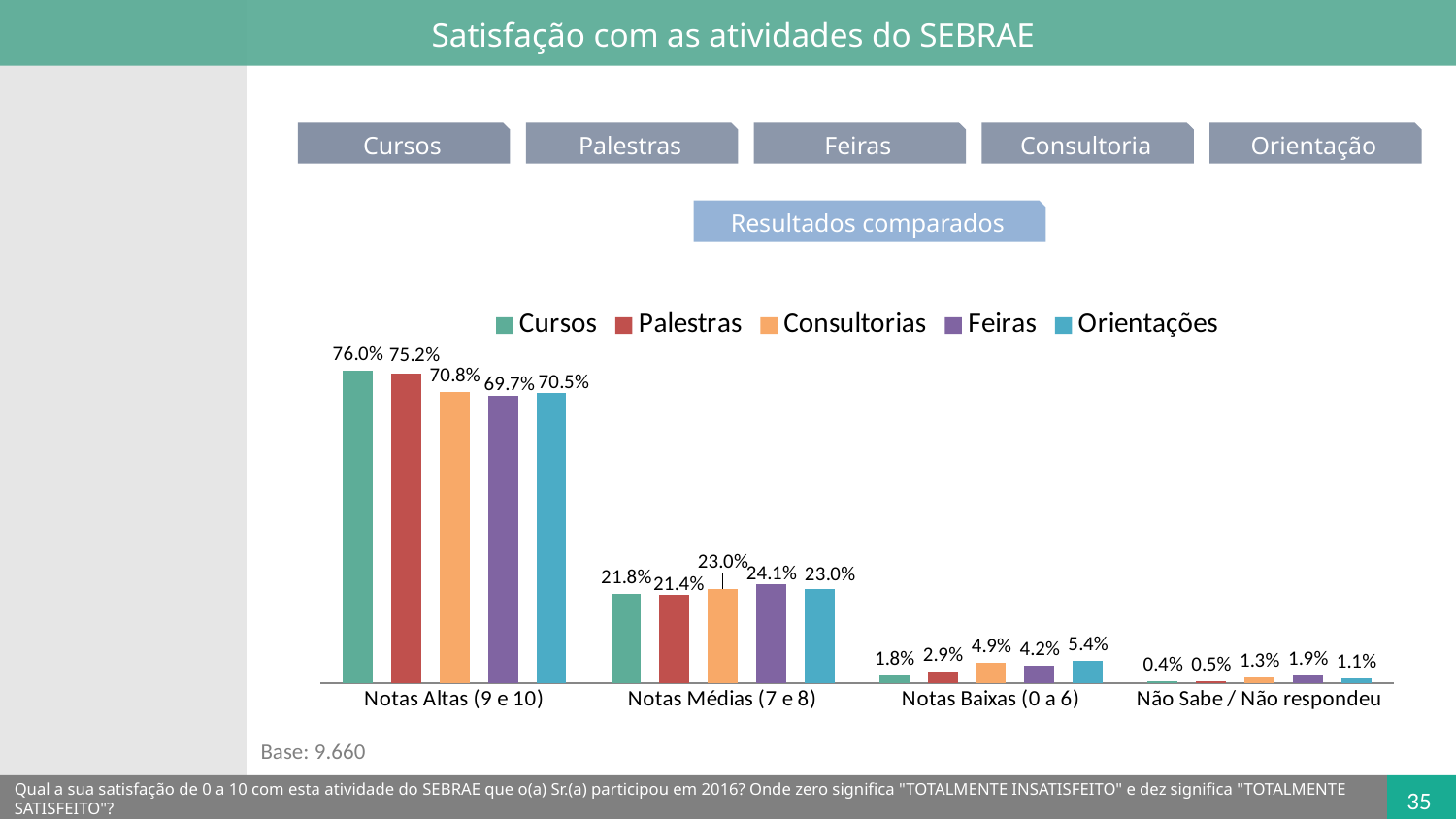
What is the value for Feiras in the Notas Médias (7 e 8) category? 24.1% How many categories are shown on the x axis? 4 What is the difference between the Cursos and Feiras values in the Notas Altas (9 e 10) category? 6.3% What is the value for Consultorias in the Não Sabe / Não respondeu category? 1.3% Which series has the highest value in the Notas Altas (9 e 10) category? Cursos In the Notas Médias (7 e 8) category, which is larger: Feiras or Palestras? Feiras What kind of chart is shown on the slide? Bar chart What is the value for Cursos in the Notas Altas (9 e 10) category? 76.0% How many series does the legend list? 5 What is the base (number of respondents) shown below the chart? 9.660 What is the value for Orientações in the Notas Baixas (0 a 6) category? 5.4% Which series has the lowest value in the Notas Baixas (0 a 6) category? Cursos